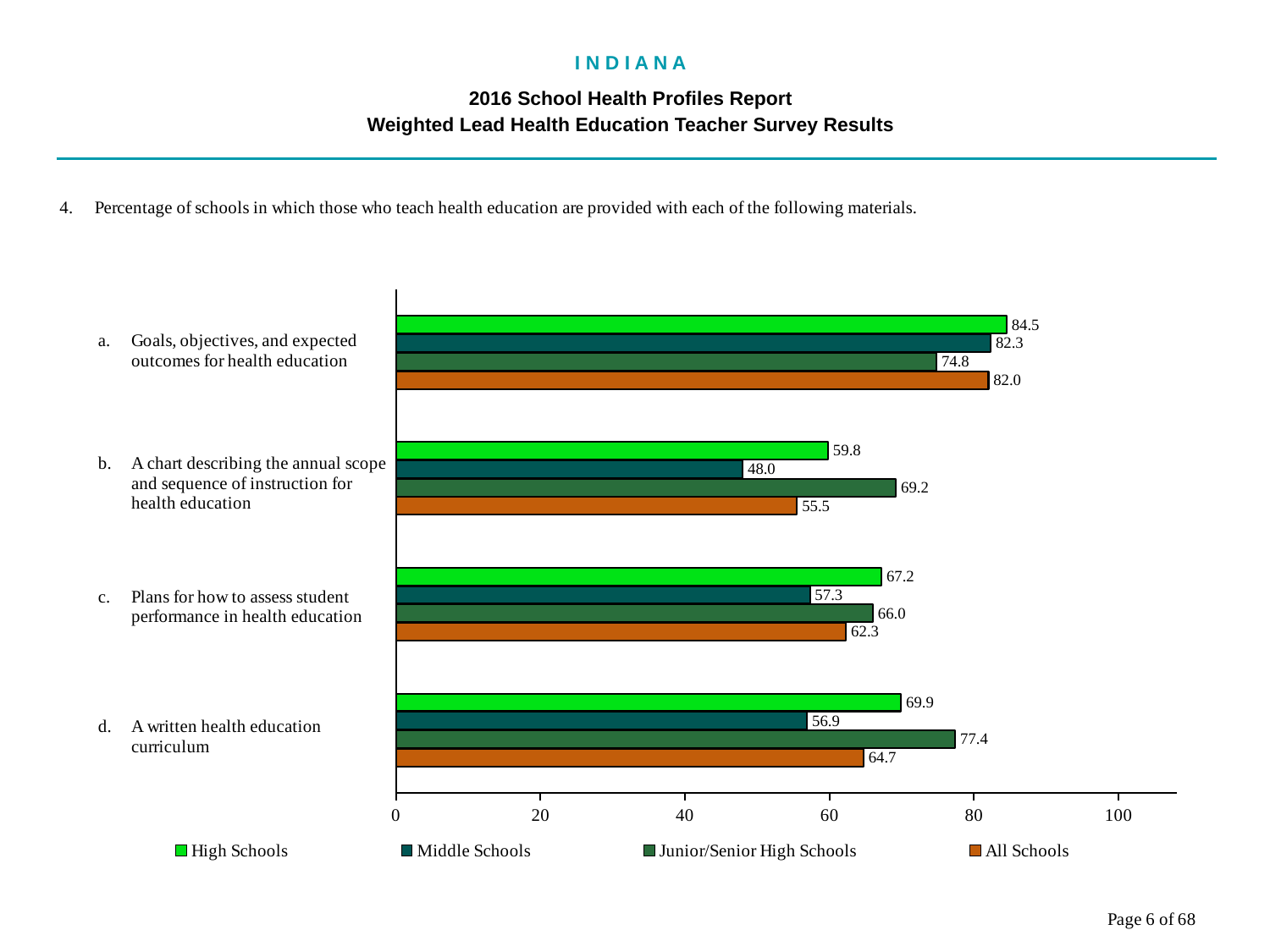
What is the difference between the High Schools and Middle Schools values for 'A written health education curriculum'? 13.0 What is the value for Junior/Senior High Schools for 'A written health education curriculum'? 77.4 What kind of chart is shown on the slide? Bar chart What is the value for All Schools for 'Plans for how to assess student performance in health education'? 62.3 Which category has the highest value for High Schools? Goals, objectives, and expected outcomes for health education What is the value for High Schools for 'Goals, objectives, and expected outcomes for health education'? 84.5 How many series does the legend list? 4 What is the value for Middle Schools for 'A chart describing the annual scope and sequence of instruction for health education'? 48.0 Which series is shown in orange in the legend? All Schools For 'A chart describing the annual scope and sequence of instruction for health education', which is larger: High Schools or Junior/Senior High Schools? Junior/Senior High Schools Which category has the lowest value for Middle Schools? A chart describing the annual scope and sequence of instruction for health education How many categories (materials) are shown on the chart? 4